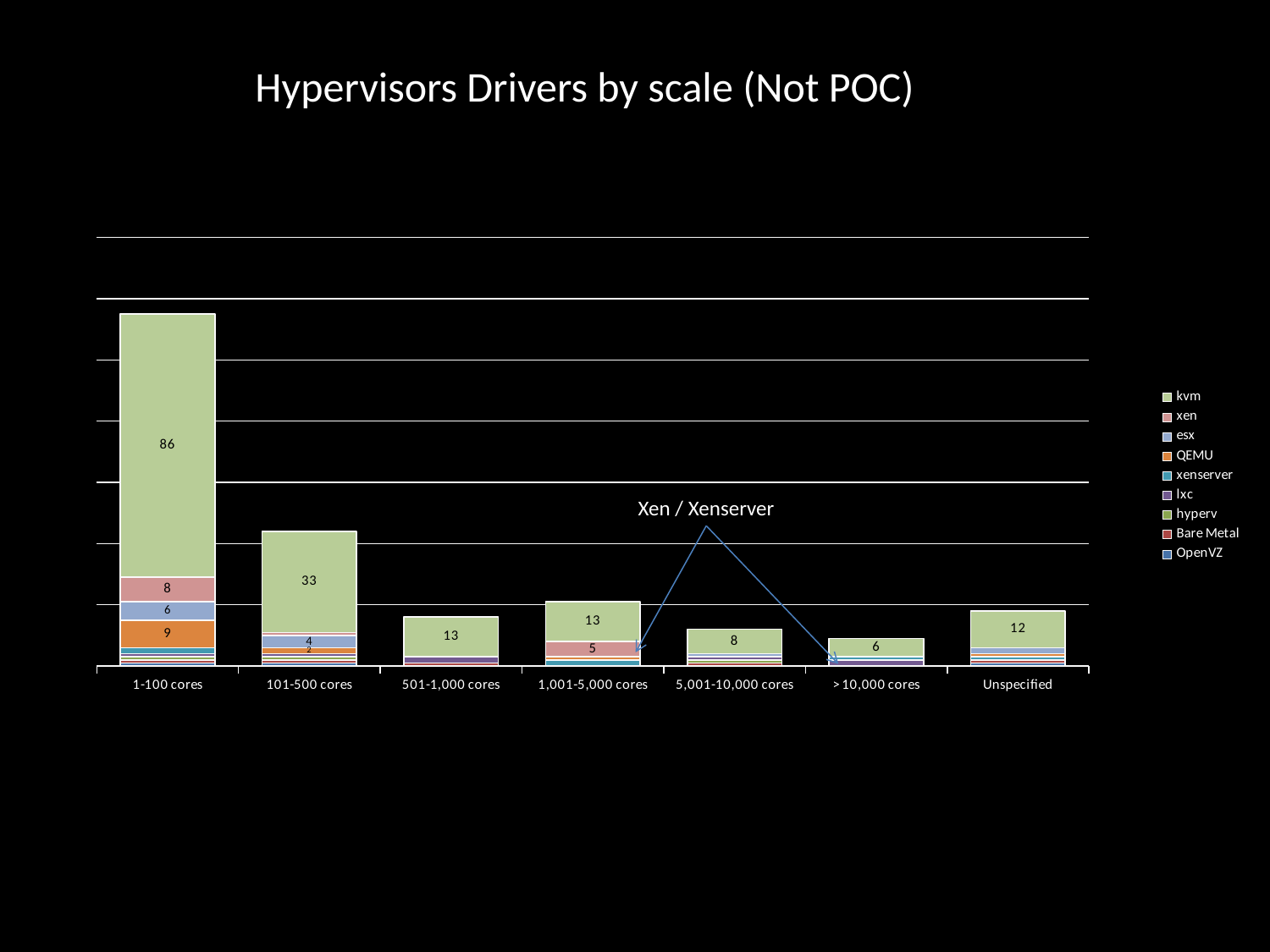
Which category has the lowest kvm value? >10,000 cores What is the title of the chart? Hypervisors Drivers by scale (Not POC) What is the kvm value for the 101-500 cores category? 33 What is the QEMU value for the 1-100 cores category? 9 What is the difference between the kvm value for 1-100 cores and the kvm value for 101-500 cores? 53 How many categories are shown along the x axis? 7 How many series does the legend list? 9 Which category has the highest kvm value? 1-100 cores What is the kvm value for the 1-100 cores category? 86 Which has the larger kvm value, 5,001-10,000 cores or Unspecified? Unspecified What is the xen value for the 1,001-5,000 cores category? 5 What kind of chart is shown on the slide? Stacked bar chart